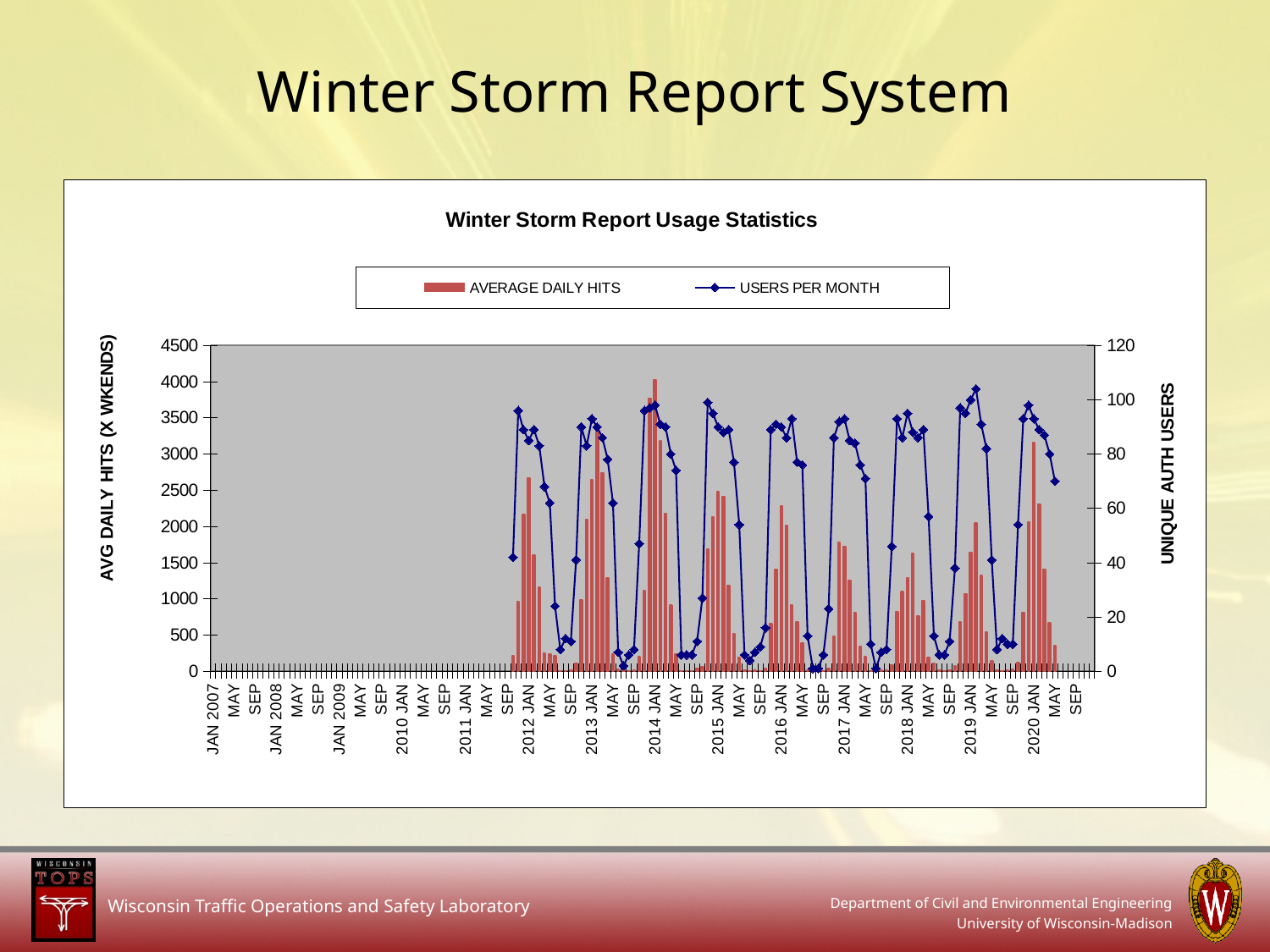
What is the label of the left vertical axis? AVG DAILY HITS (X WKENDS) In which year does the tallest AVERAGE DAILY HITS bar occur? 2014 What kind of chart is shown on the slide? A combined bar and line chart What is the highest tick value shown on the right vertical axis? 120 Is the tallest AVERAGE DAILY HITS bar, around JAN 2014, greater or less than 3500? greater How many series does the legend of the chart list? 2 Which series is plotted as bars in the chart? AVERAGE DAILY HITS What is the label of the right vertical axis? UNIQUE AUTH USERS Is the peak USERS PER MONTH value around JAN 2019 greater or less than 100? greater What is the title of the chart? Winter Storm Report Usage Statistics What is the highest tick value shown on the left vertical axis? 4500